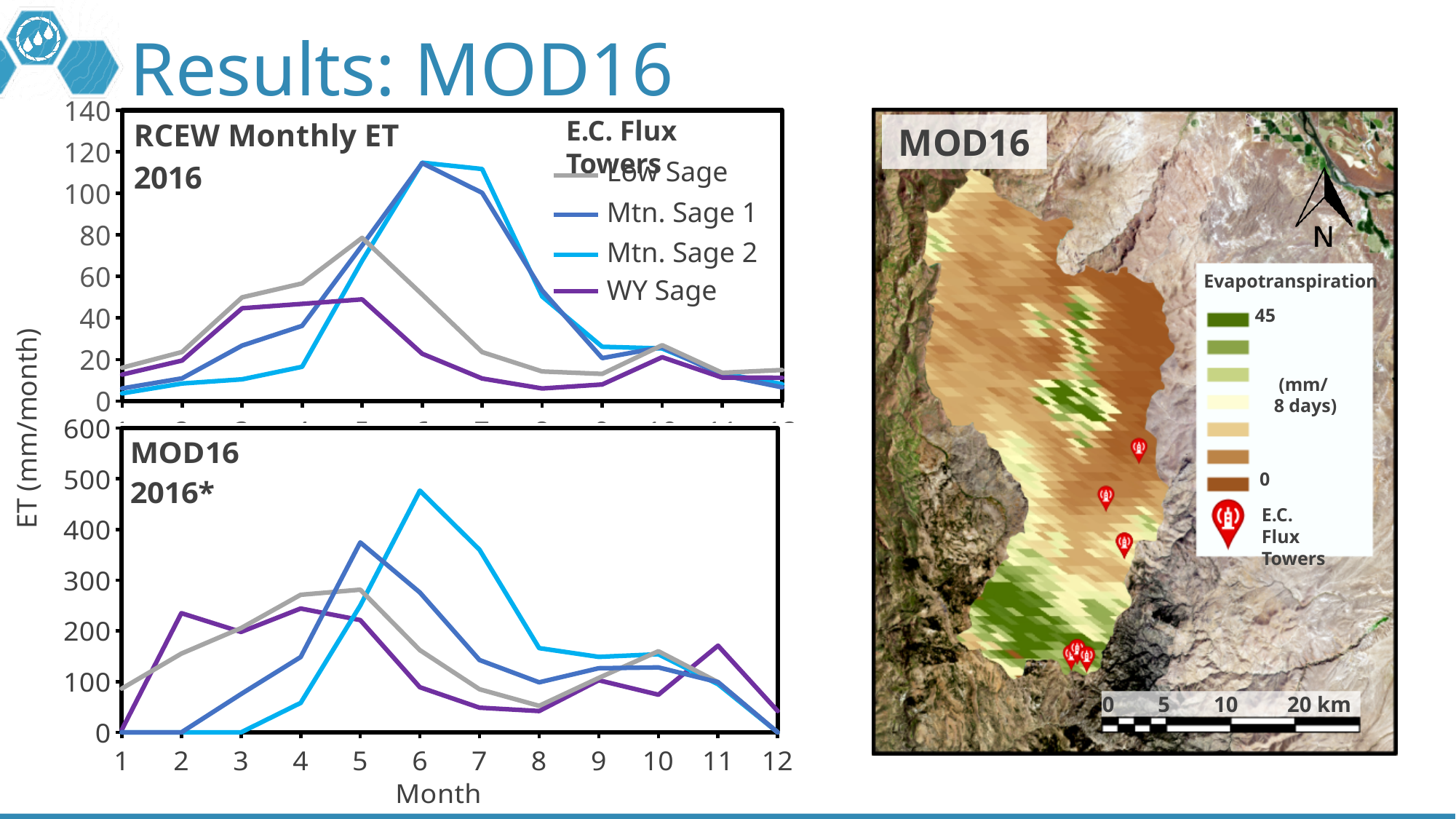
In the top chart 'RCEW Monthly ET 2016', which series has the lowest value in month 3? Mtn. Sage 2 In the bottom chart 'MOD16 2016*', is the value for Mtn. Sage 2 in month 6 greater or less than 400? greater How many months are plotted along the x axis of the bottom chart 'MOD16 2016*'? 12 What is the label on the shared y axis of the two line charts? ET (mm/month) In the bottom chart 'MOD16 2016*', which series has the highest value in month 2? WY Sage In the bottom chart 'MOD16 2016*', which series reaches the highest peak value? Mtn. Sage 2 What kind of chart is the top chart titled 'RCEW Monthly ET 2016'? line chart How many series does the legend list for the charts? 4 In the bottom chart 'MOD16 2016*', is the value for Mtn. Sage 2 in month 1 greater or less than 100? less In the top chart 'RCEW Monthly ET 2016', is the value for WY Sage in month 6 greater or less than 40? less In the bottom chart 'MOD16 2016*', which is larger in month 5: Mtn. Sage 1 or Low Sage? Mtn. Sage 1